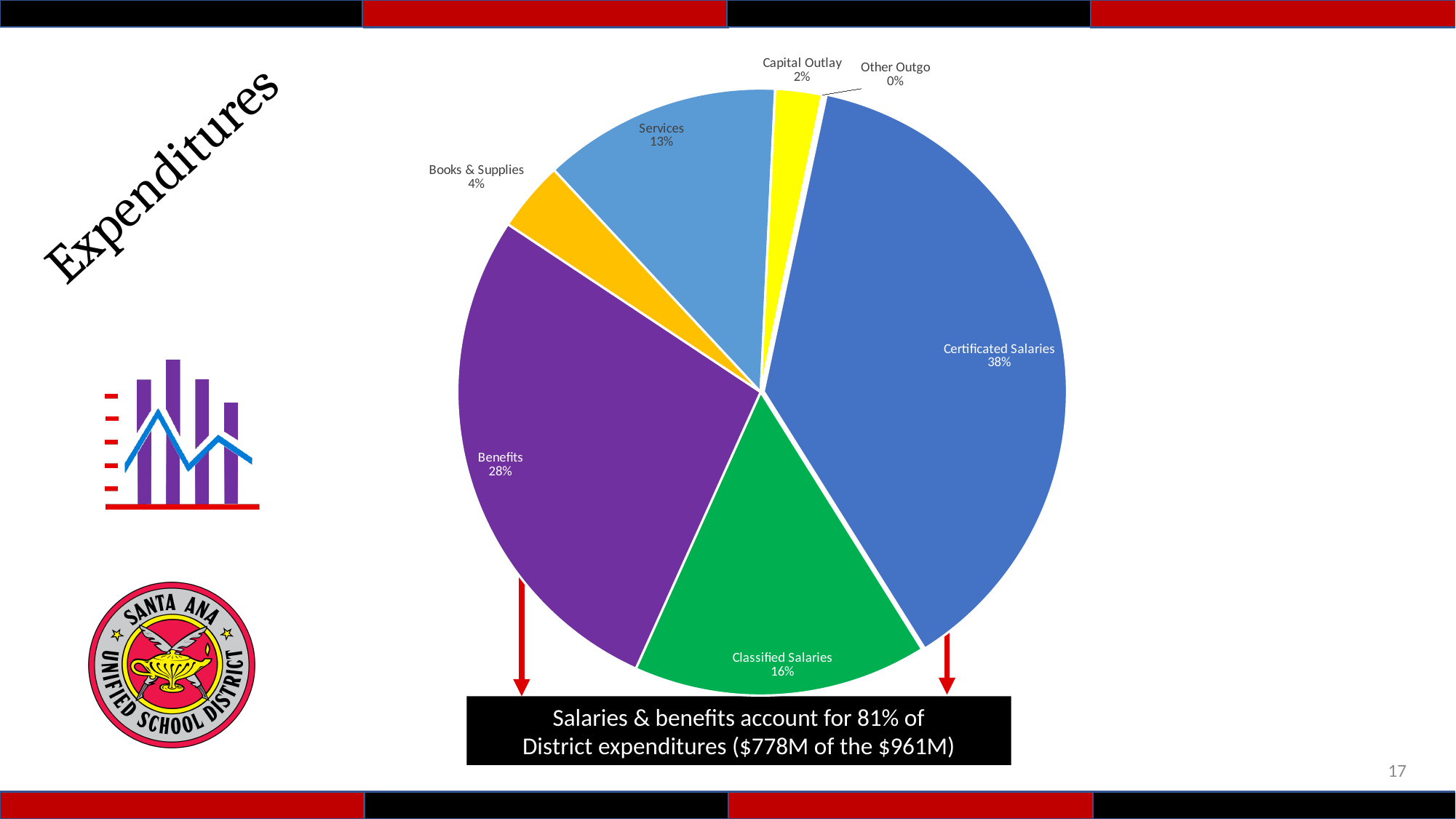
What share of expenditures is Benefits? 28% What share of expenditures is Certificated Salaries? 38% Which category has the smallest share of expenditures? Other Outgo What kind of chart is shown on the slide? pie chart Which is larger, Services or Classified Salaries? Classified Salaries What share of expenditures is Capital Outlay? 2% What share of expenditures is Services? 13% What share of expenditures is Books & Supplies? 4% How many categories are shown in the pie chart? 7 What share of expenditures is Classified Salaries? 16% What is the difference in percentage points between Certificated Salaries and Benefits? 10 Which category has the largest share of expenditures? Certificated Salaries